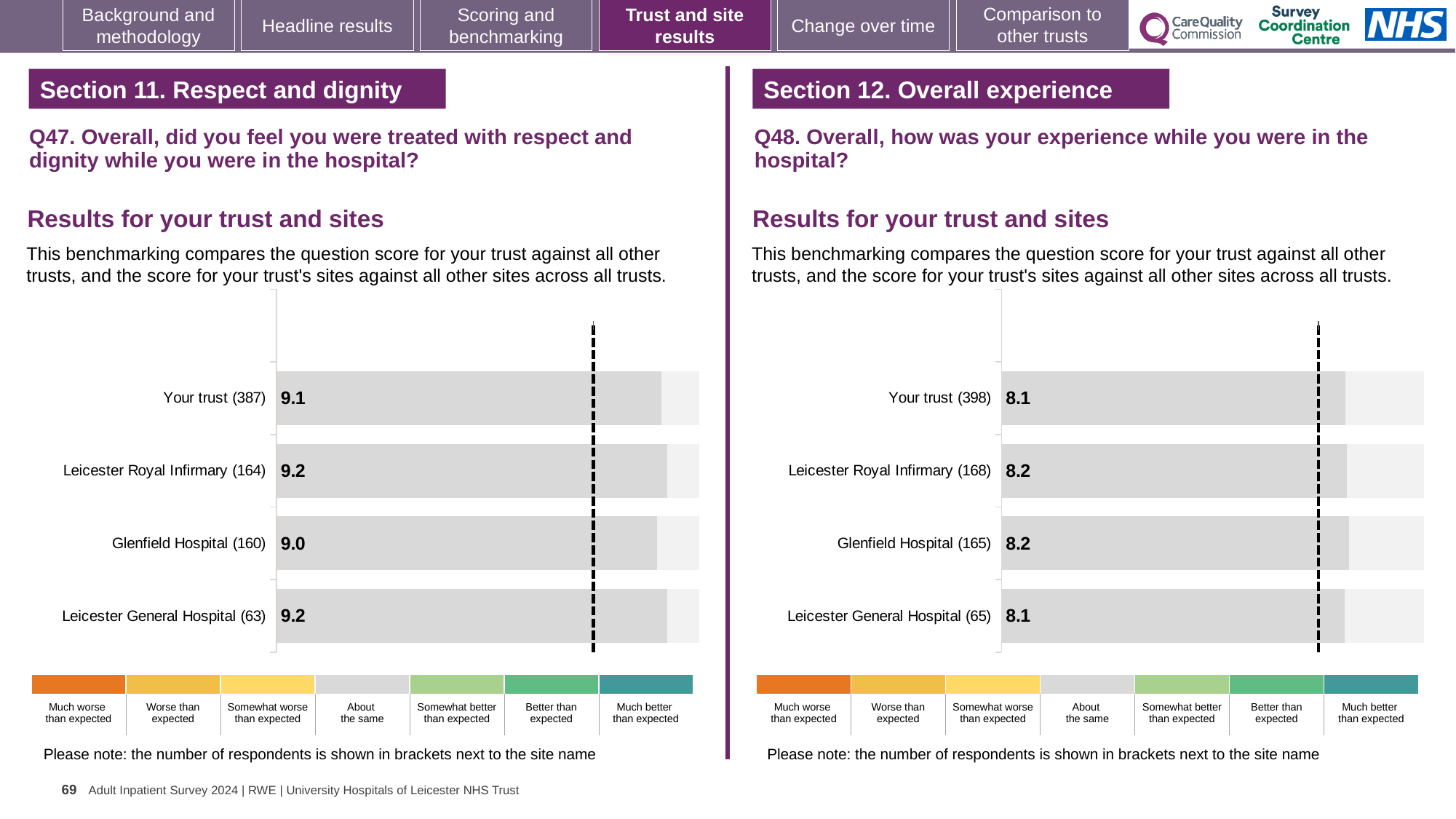
In the Q47 chart on the left, which site has the lowest score? Glenfield Hospital In the Q47 chart on the left, what is the score for Your trust? 9.1 In the Q47 chart on the left, which has the higher score, Your trust or Leicester General Hospital? Leicester General Hospital In the Q48 chart on the right, what is the difference between the scores for Glenfield Hospital and Your trust? 0.1 In the Q47 chart on the left, how many respondents are shown in brackets for Leicester General Hospital? 63 In the Q48 chart on the right, what is the score for Leicester General Hospital? 8.1 How many bars are plotted in the Q48 chart on the right? 4 In the Q48 chart on the right, what is the score for Leicester Royal Infirmary? 8.2 In the Q47 chart on the left, what is the score for Glenfield Hospital? 9.0 What kind of chart is used for the Q47 results on the left? Bar chart In the Q47 chart on the left, what is the difference between the scores for Leicester Royal Infirmary and Glenfield Hospital? 0.2 In the Q48 chart on the right, what is the score for Your trust? 8.1